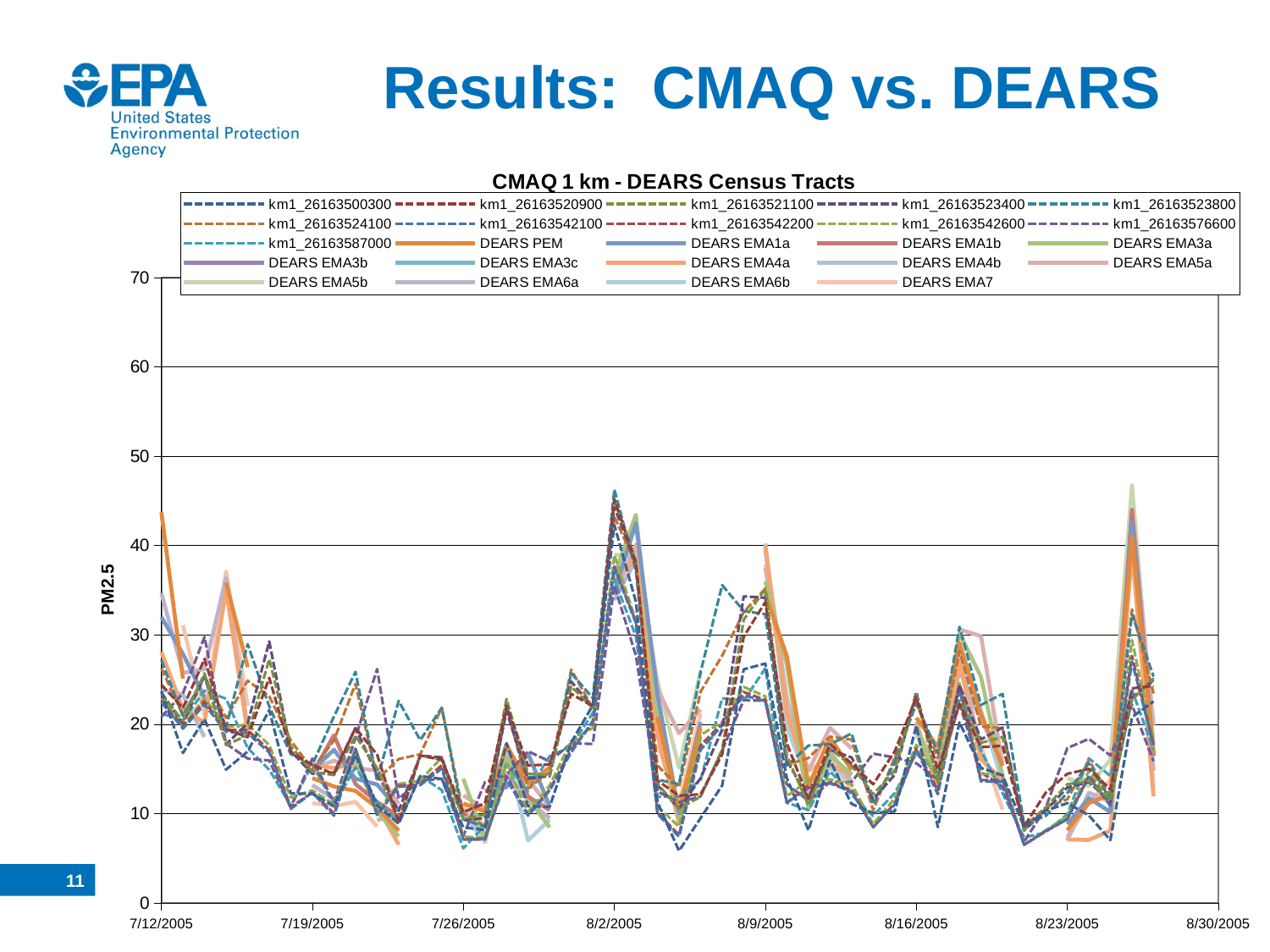
How many series does the legend list? 24 How many date labels are shown on the x axis? 8 What kind of chart is shown on the slide? line chart Is the highest value reached by any series on the chart greater or less than 50? less What is the last date shown on the x axis? 8/30/2005 What is the label on the y axis of the chart? PM2.5 What is the first date shown on the x axis? 7/12/2005 How many series in the legend have names beginning with "DEARS"? 13 How many series in the legend have names beginning with "km1_"? 11 What is the title of the chart? CMAQ 1 km - DEARS Census Tracts Is the peak value reached by the series near 8/2/2005 greater or less than 40? greater What is the highest value shown on the y axis? 70